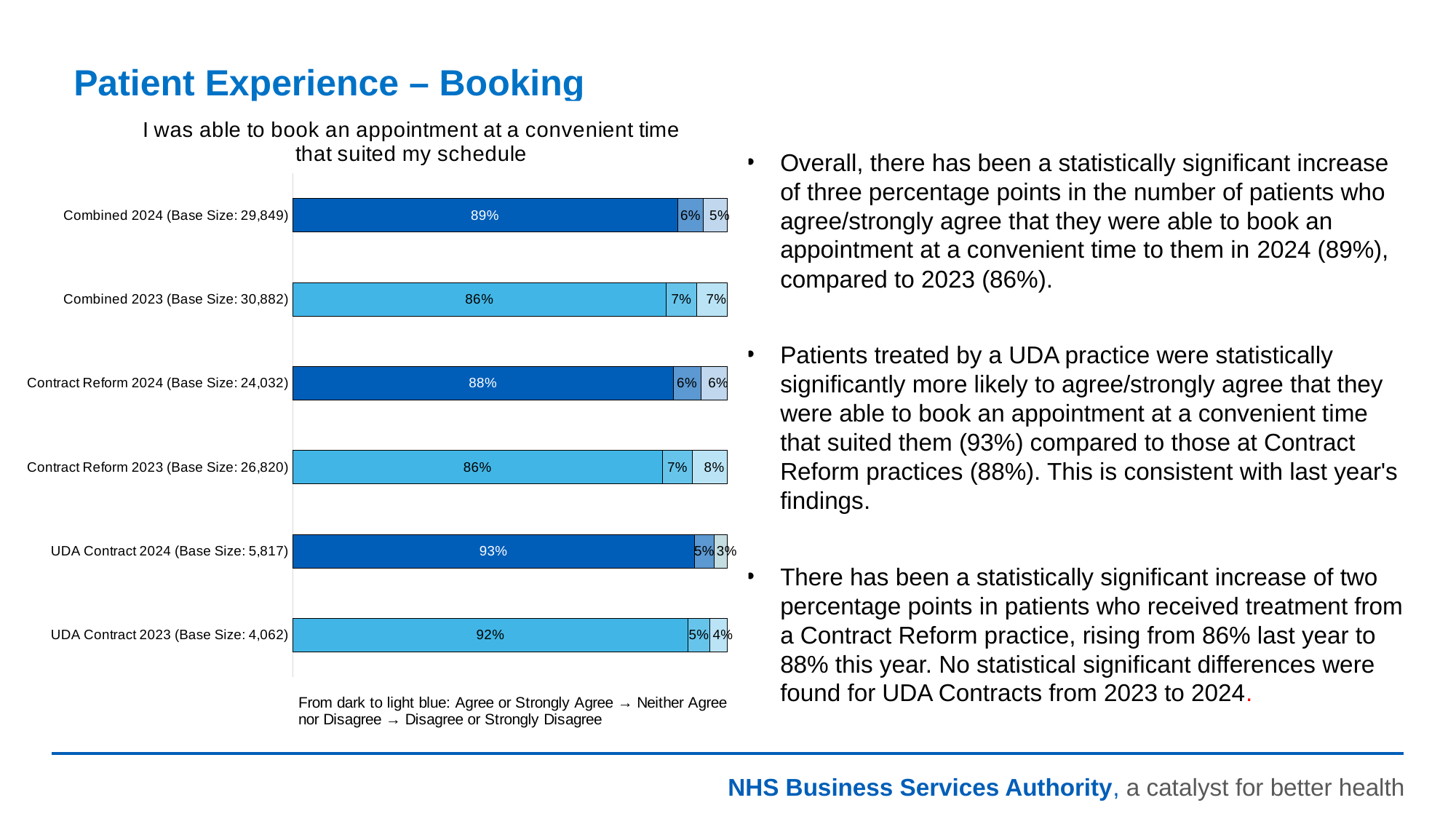
How many response groups does each stacked bar contain? 3 Which category has the highest 'Disagree or Strongly Disagree' percentage? Contract Reform 2023 (Base Size: 26,820) How many categories (bars) are shown in the chart? 6 Which has a larger 'Agree or Strongly Agree' percentage: Contract Reform 2024 or UDA Contract 2023? UDA Contract 2023 What is the 'Disagree or Strongly Disagree' value for UDA Contract 2024? 3% What is the 'Neither Agree nor Disagree' value for Contract Reform 2023? 7% What is the difference in 'Agree or Strongly Agree' percentage between Combined 2024 and Combined 2023? 3 percentage points Which category has the highest 'Agree or Strongly Agree' percentage? UDA Contract 2024 (Base Size: 5,817) What is the base size for Contract Reform 2024? 24,032 What is the total of the three segments for the UDA Contract 2023 bar? 101% What type of chart is shown on the slide? Stacked bar chart What percentage of Combined 2024 respondents agreed or strongly agreed that they were able to book an appointment at a convenient time? 89%